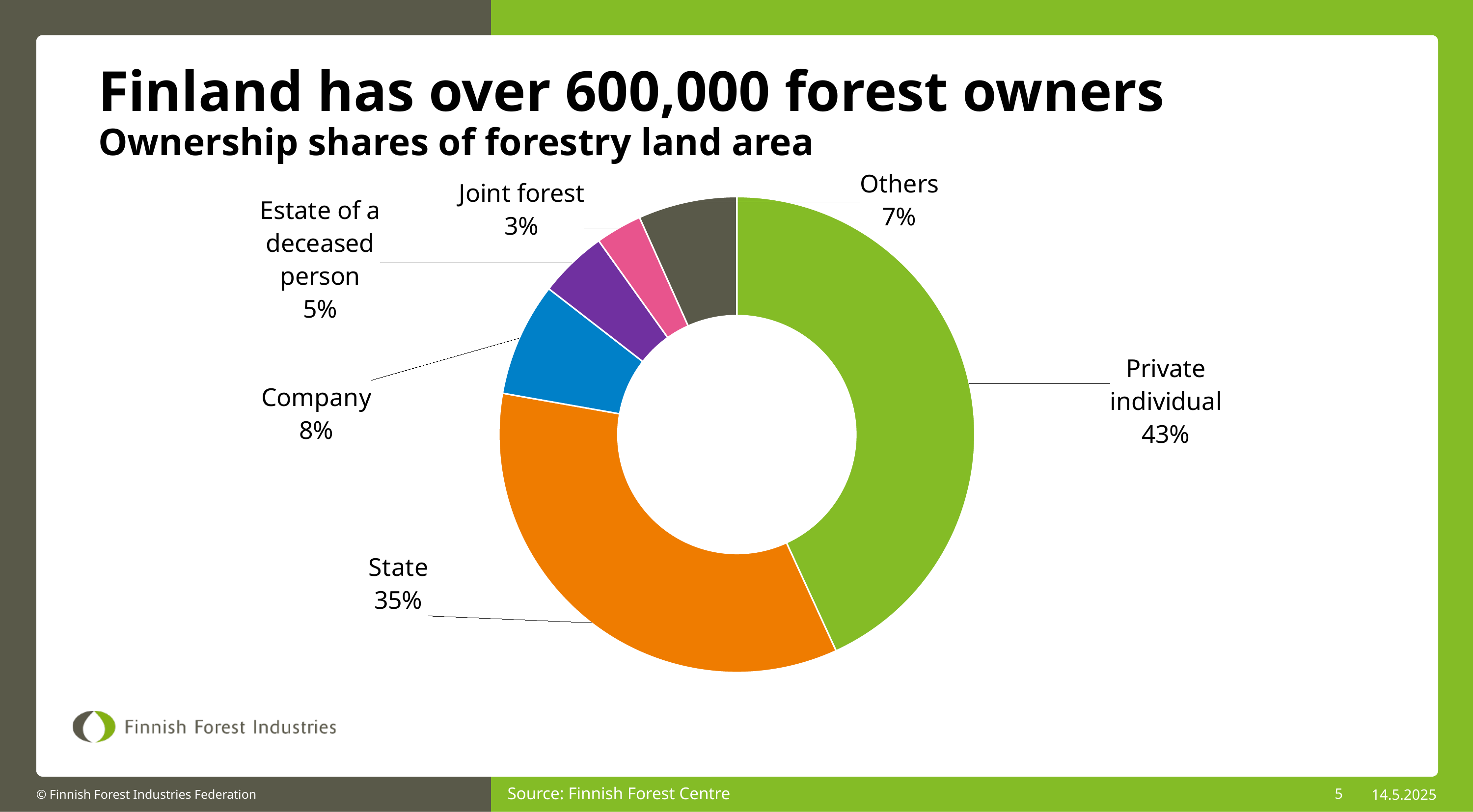
Which ownership category has the largest share of forestry land area? Private individual What colour is the State slice in the chart? Orange What kind of chart is shown on the slide? Pie chart (doughnut) Which ownership category has the smallest share of forestry land area? Joint forest What share of forestry land area is owned by private individuals? 43% What share of forestry land area is owned by companies? 8% Which has a larger share of forestry land area, Company or Others? Company How many ownership categories are shown in the chart? 6 What share of forestry land area is owned by the State? 35% What share of forestry land area is held by joint forests? 3% What is the combined share of Estate of a deceased person and Joint forest? 8% What is the difference in percentage points between the Private individual share and the State share? 8